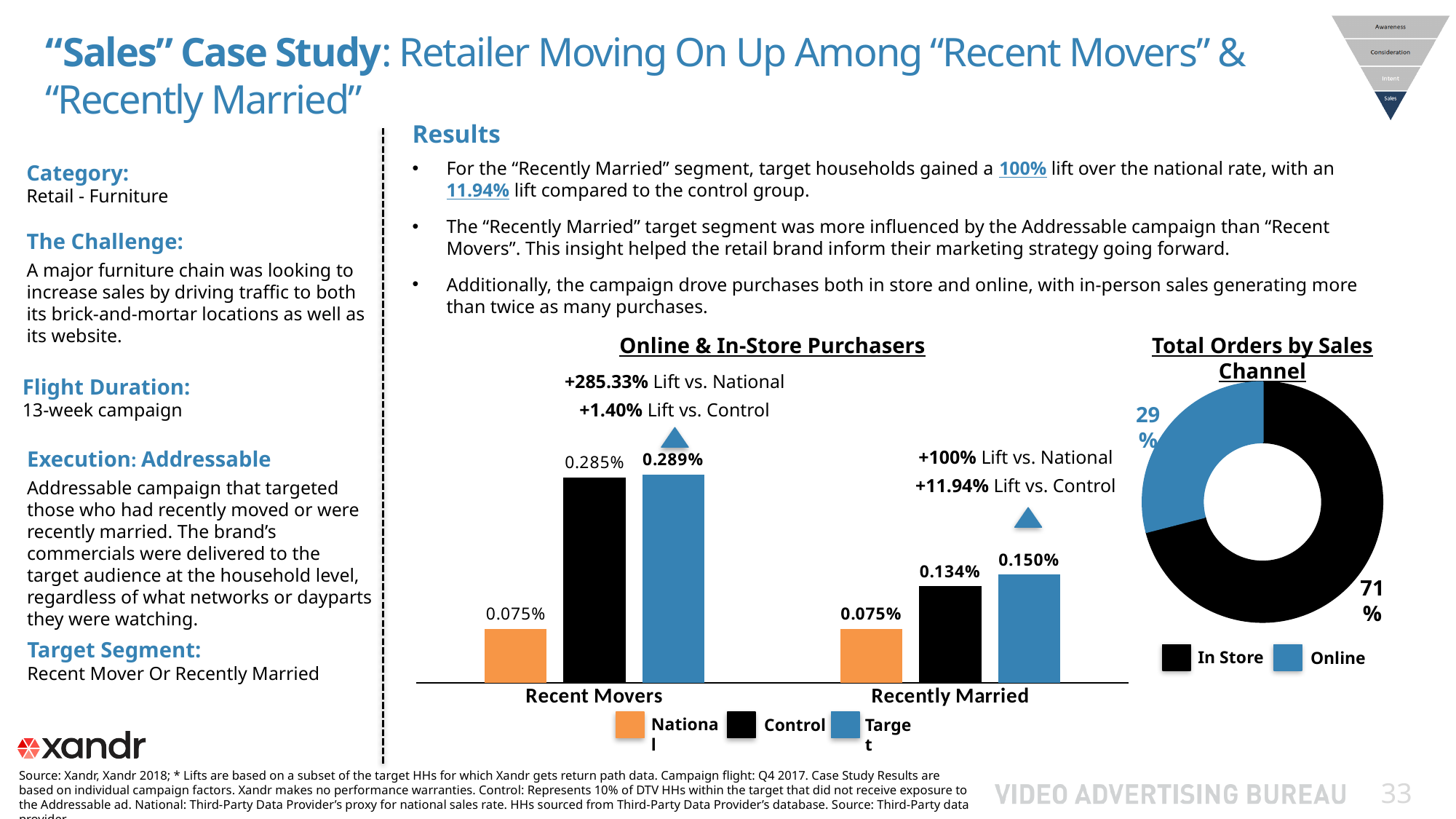
In the "Online & In-Store Purchasers" chart, what is the Target value for Recent Movers? 0.289% In the "Total Orders by Sales Channel" chart, what share of orders is In Store? 71% In the "Online & In-Store Purchasers" chart, what is the difference between the Target and Control values for Recently Married? 0.016% In the "Online & In-Store Purchasers" chart, which series has the lowest value for Recent Movers? National What kind of chart is "Total Orders by Sales Channel"? Donut chart In the "Online & In-Store Purchasers" chart, what is the Control value for Recently Married? 0.134% How many series does the legend of the "Online & In-Store Purchasers" chart list? 3 In the "Online & In-Store Purchasers" chart, is the Control value larger for Recent Movers or for Recently Married? Recent Movers In the "Total Orders by Sales Channel" chart, which channel has the smaller share? Online What kind of chart is "Online & In-Store Purchasers"? Bar chart In the "Online & In-Store Purchasers" chart, which series has the highest value for Recently Married? Target In the "Online & In-Store Purchasers" chart, what is the National value for Recent Movers? 0.075%